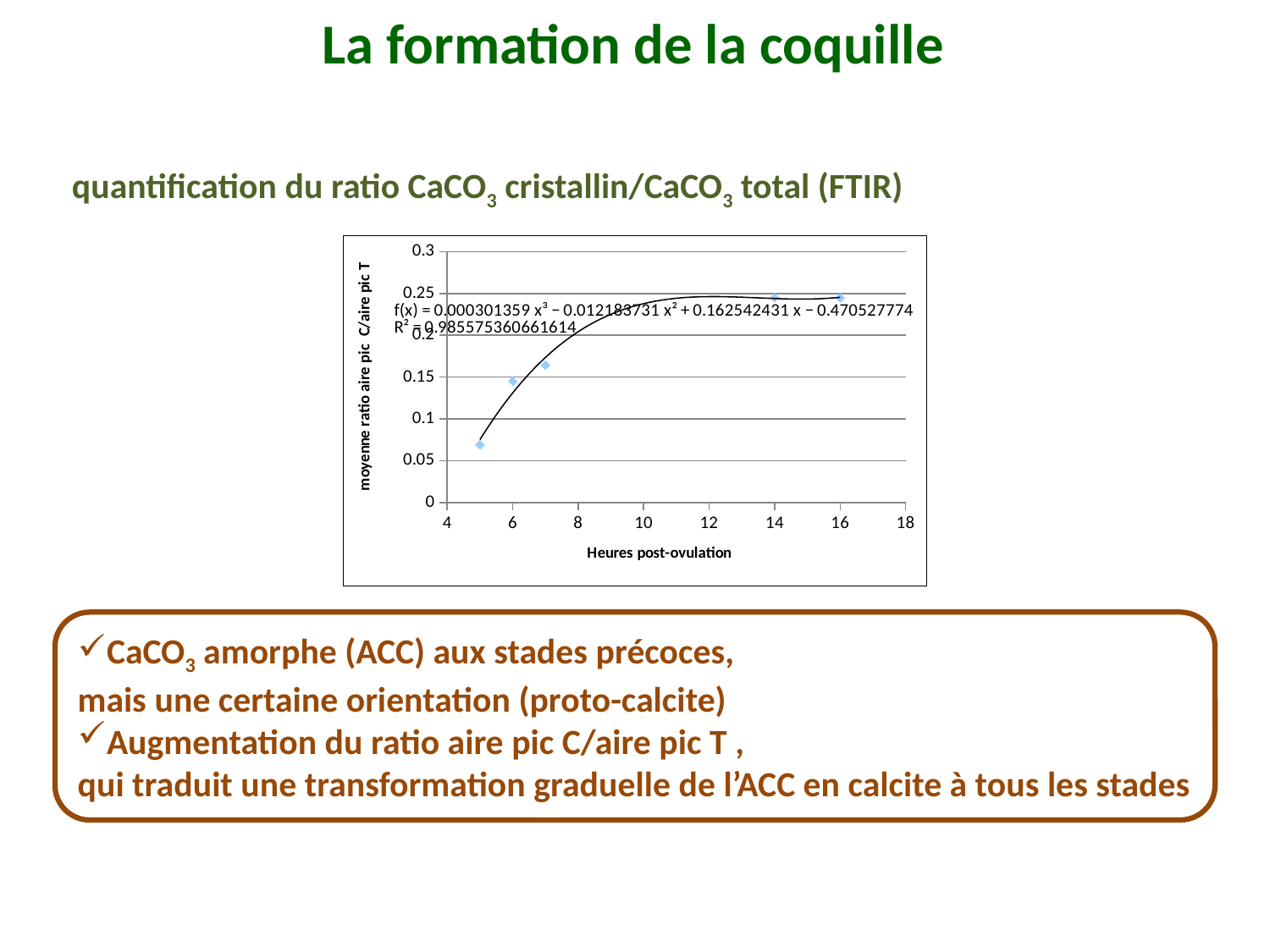
What kind of chart is shown on the slide? scatter plot Is the value at 5 hours post-ovulation greater or less than 0.1? less What R² value is printed for the trendline on the chart? 0.985575360661614 Which is larger, the value at 5 hours post-ovulation or the value at 14 hours post-ovulation? 14 hours post-ovulation Is the value at 14 hours post-ovulation greater or less than 0.2? greater Do the plotted values rise or fall as the hours post-ovulation increase? rise What is the title of the y axis of the chart? moyenne ratio aire pic C/aire pic T Is the value at 6 hours post-ovulation greater or less than 0.1? greater How many data points are plotted on the chart? 5 What is the title of the x axis of the chart? Heures post-ovulation At which number of hours post-ovulation is the plotted ratio lowest? 5